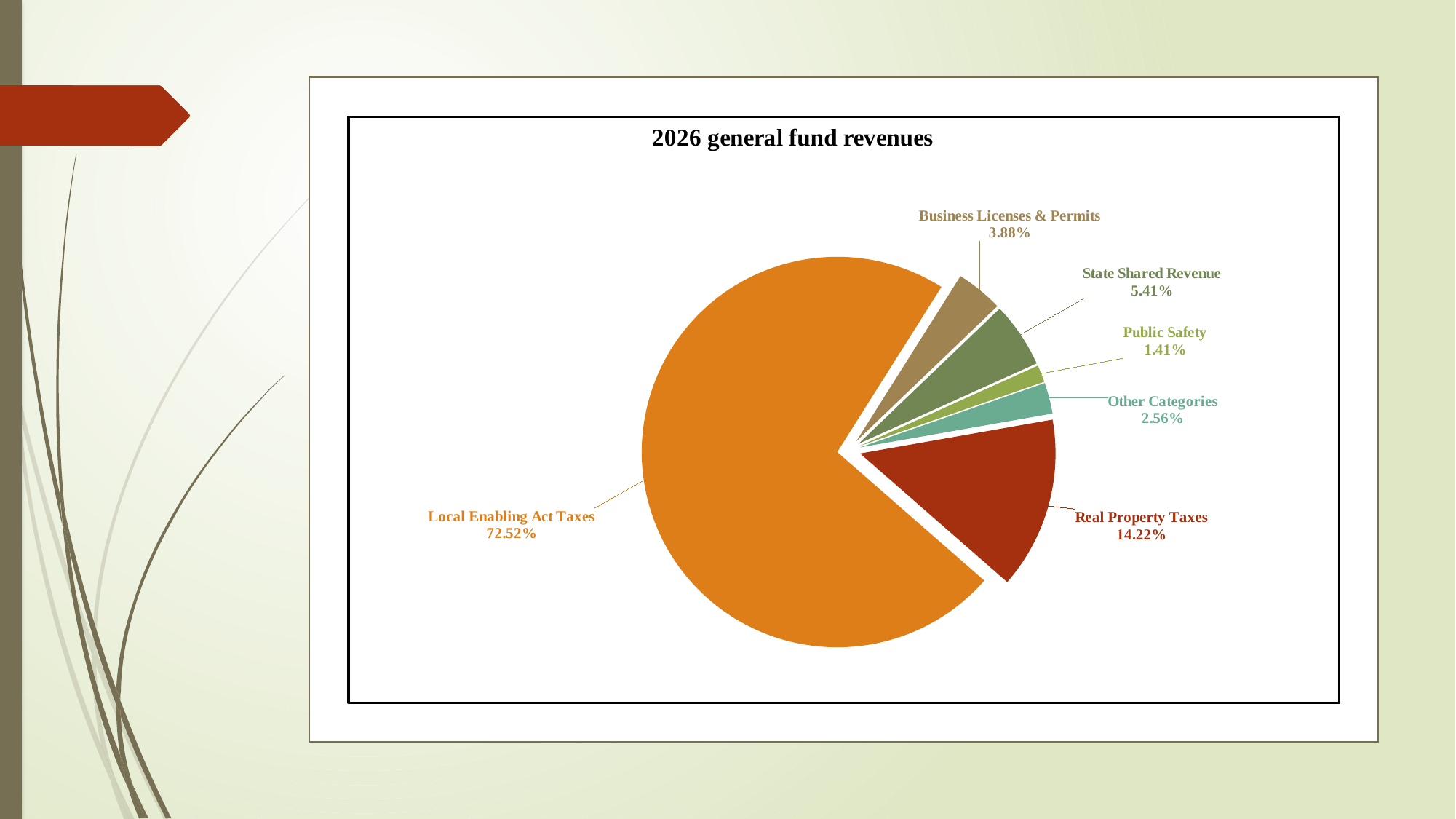
Which is larger, the share for Business Licenses & Permits or the share for Other Categories? Business Licenses & Permits What is the title of the chart? 2026 general fund revenues What is the difference in percentage points between Real Property Taxes and State Shared Revenue? 8.81 What kind of chart is shown on the slide? pie chart How many slices does the pie chart have? 6 Which category has the largest share of the pie? Local Enabling Act Taxes What percentage is shown for State Shared Revenue? 5.41% What percentage is shown for Real Property Taxes? 14.22% What share of 2026 general fund revenues comes from Local Enabling Act Taxes? 72.52% What percentage is shown for Other Categories? 2.56% What percentage is shown for Business Licenses & Permits? 3.88% Which category has the smallest share of the pie? Public Safety